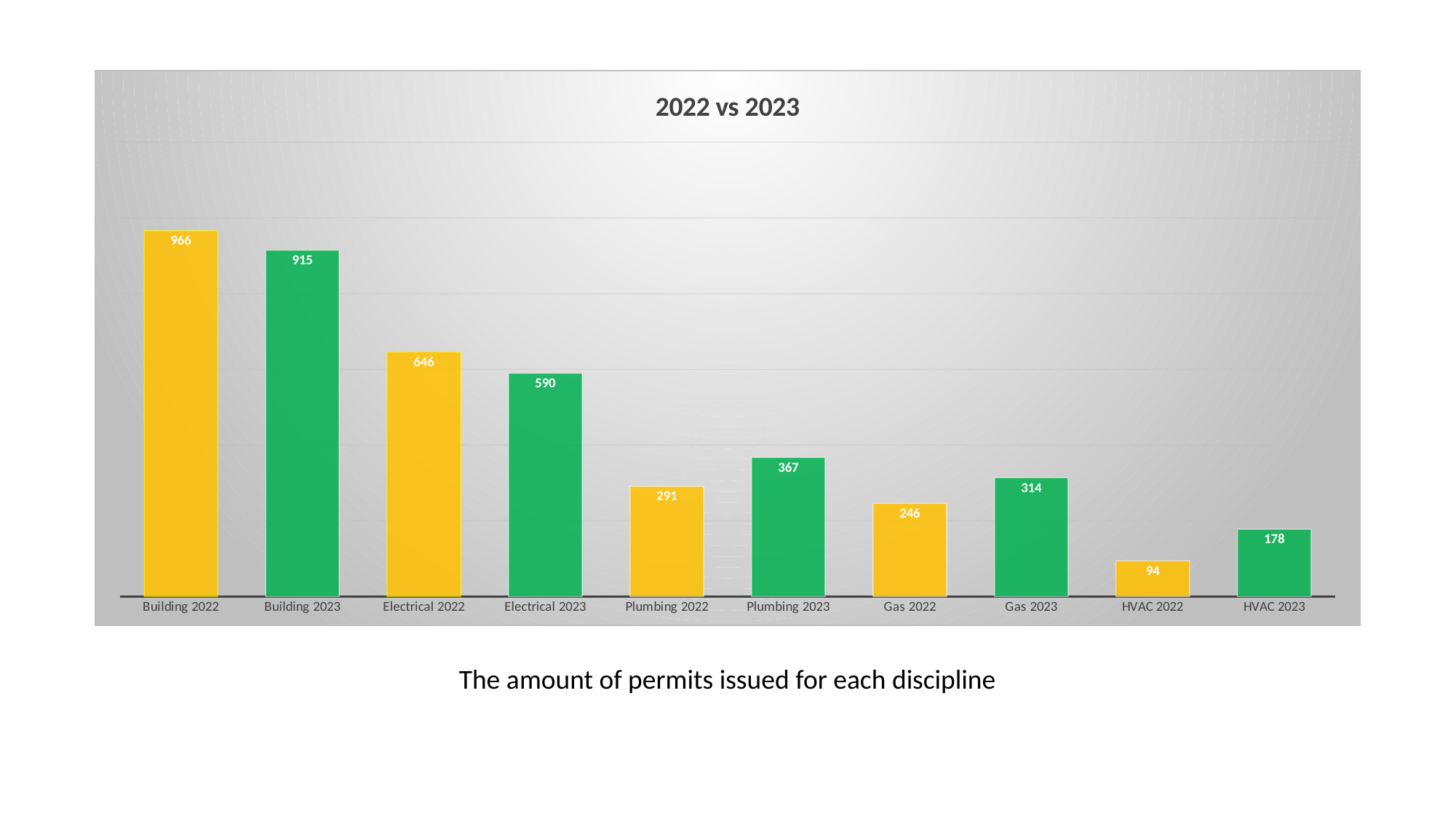
What is the value for Plumbing 2023? 367 What is the difference between HVAC 2023 and HVAC 2022? 84 Which is larger, Electrical 2022 or Electrical 2023? Electrical 2022 Which is larger, Gas 2022 or Gas 2023? Gas 2023 What is the title of the chart? 2022 vs 2023 Which category has the highest value? Building 2022 How many bars are shown in the chart? 10 What is the difference between Building 2022 and Building 2023? 51 What is the value for HVAC 2022? 94 What is the value for Building 2022? 966 Which category has the lowest value? HVAC 2022 What kind of chart is shown on the slide? Bar chart